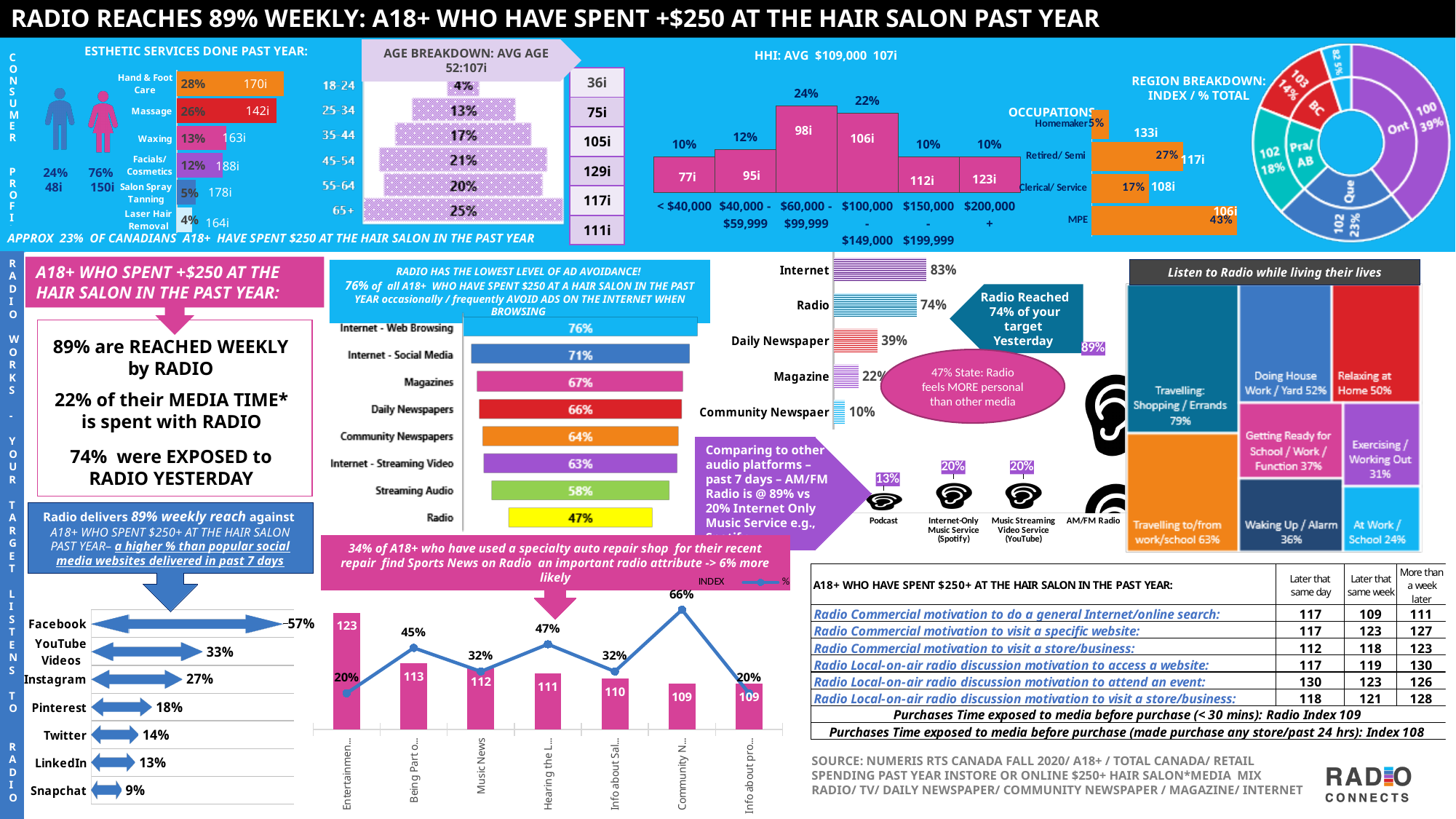
In the HHI bar chart, what percentage is shown for the $60,000 - $99,999 income group? 24% In the ad avoidance bar chart, what is the difference between Internet - Social Media and Magazines? 4% In the media reached yesterday chart (Internet, Radio, Daily Newspaper, Magazine, Community Newspaper), which is larger: Radio or Daily Newspaper? Radio In the ad avoidance bar chart (Internet - Web Browsing through Radio), what percentage is shown for Radio? 47% In the Listen to Radio while living their lives treemap, what percentage is shown for Travelling: Shopping / Errands? 79% In the social media reach chart (Facebook through Snapchat), what percentage is shown for Instagram? 27% In the social media reach chart, which platform has the lowest percentage? Snapchat How many social media platforms are listed in the social media reach chart (Facebook through Snapchat)? 7 In the Esthetic Services Done Past Year chart, what index is shown for Facials/Cosmetics? 188i In the ad avoidance bar chart, which medium has the highest level of ad avoidance? Internet - Web Browsing In the HHI bar chart, which income group has the highest index? $200,000 + In the Age Breakdown chart, what percentage is shown for the 45-54 age group? 21%